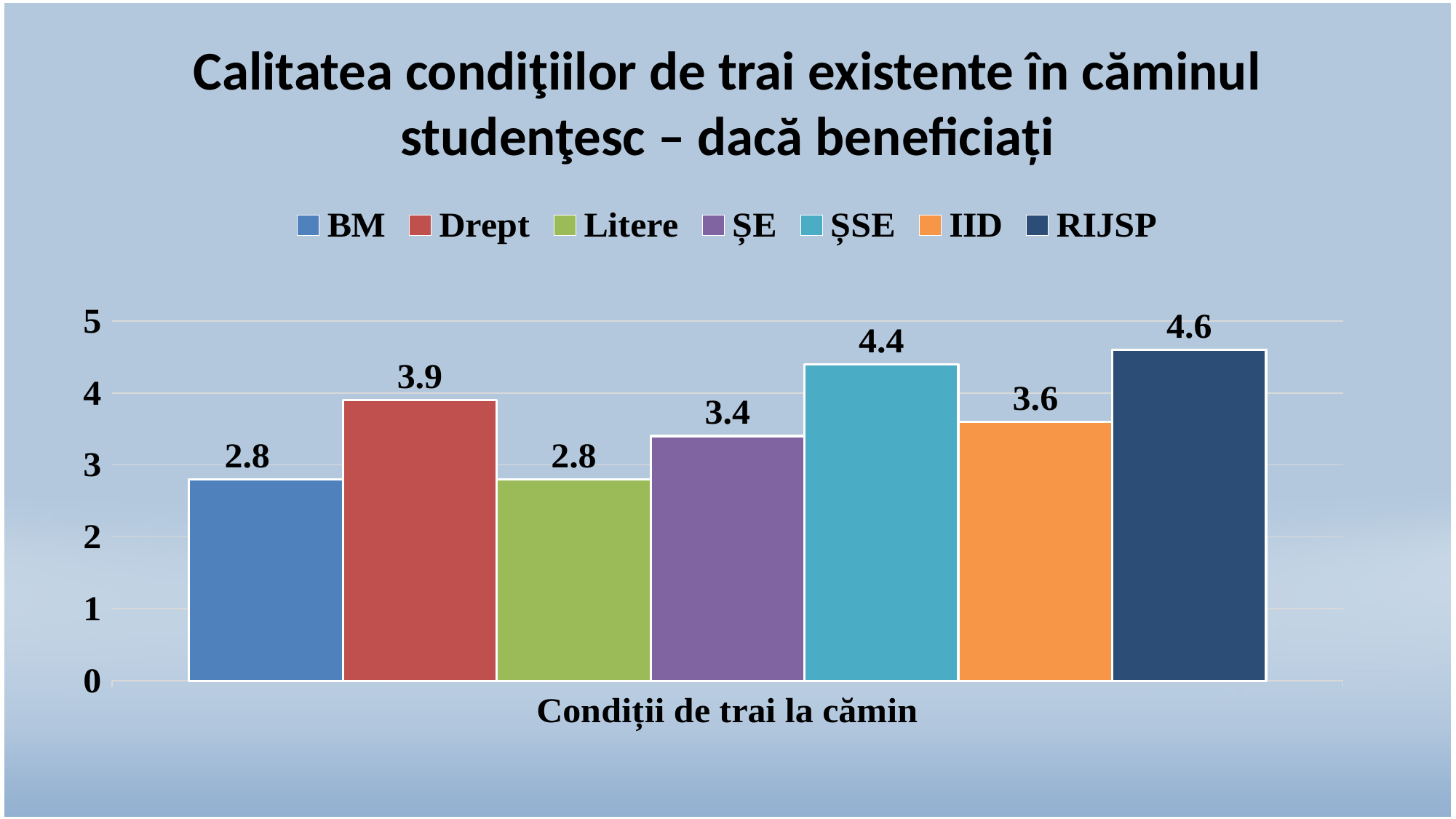
What is the difference between the values for RIJSP and BM? 1.8 Which series has the highest value? RIJSP What is the x-axis label of the chart? Condiții de trai la cămin What is the difference between the values for ȘSE and ȘE? 1 What is the value for Drept? 3.9 What kind of chart is shown on the slide? bar chart Which two series share the same value of 2.8? BM and Litere Which is larger, the value for Drept or the value for IID? Drept How many series does the legend list? 7 What is the value for IID? 3.6 Is the value for ȘE greater or less than 3? greater What is the value for ȘSE? 4.4